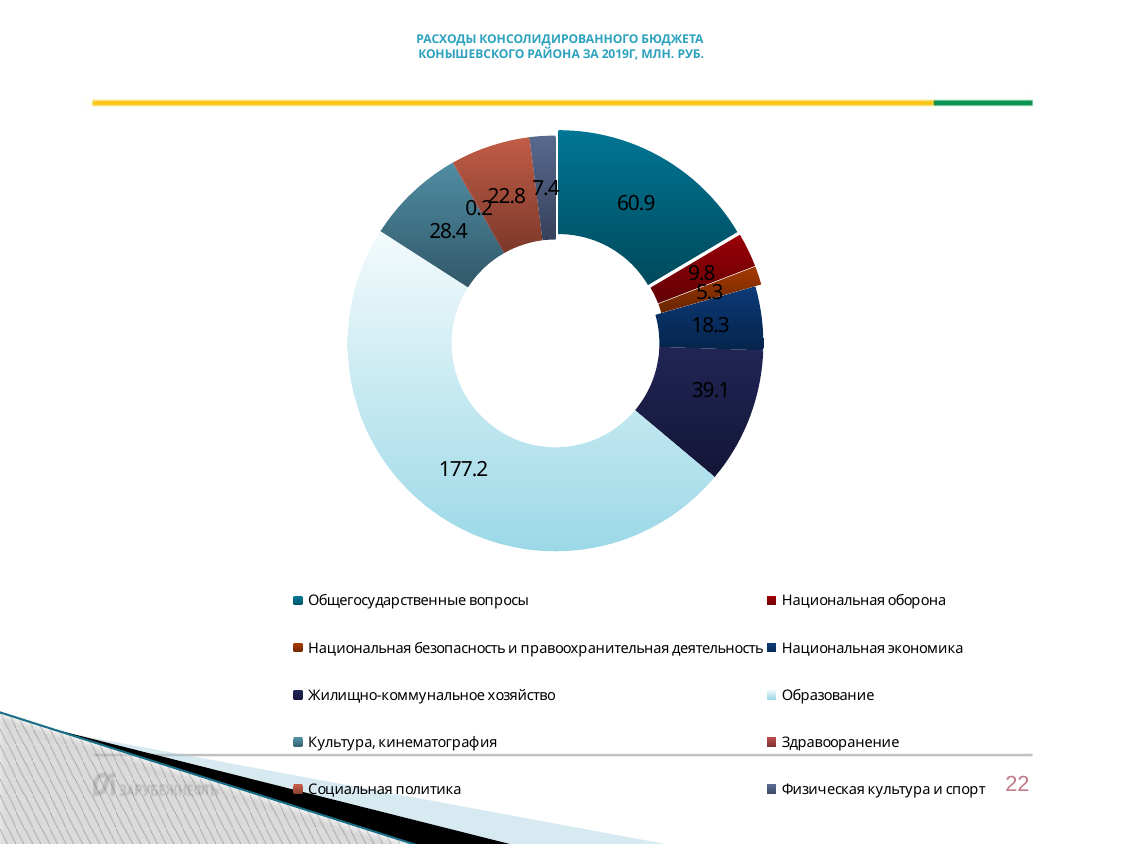
What is the value for Общегосударственные вопросы? 60.9 Which category has the largest value? Образование What is the value for Национальная экономика? 18.3 What is the title of the chart? РАСХОДЫ КОНСОЛИДИРОВАННОГО БЮДЖЕТА КОНЫШЕВСКОГО РАЙОНА ЗА 2019Г, МЛН. РУБ. What kind of chart is shown on the slide? Pie (doughnut) chart How many categories does the chart show? 10 What is the difference between the values for Образование and Общегосударственные вопросы? 116.3 Which is larger, the value for Культура, кинематография or the value for Социальная политика? Культура, кинематография What is the value for Образование? 177.2 What is the value for Жилищно-коммунальное хозяйство? 39.1 Which category has the smallest value? Здравооранение What is the difference between the values for Жилищно-коммунальное хозяйство and Национальная экономика? 20.8